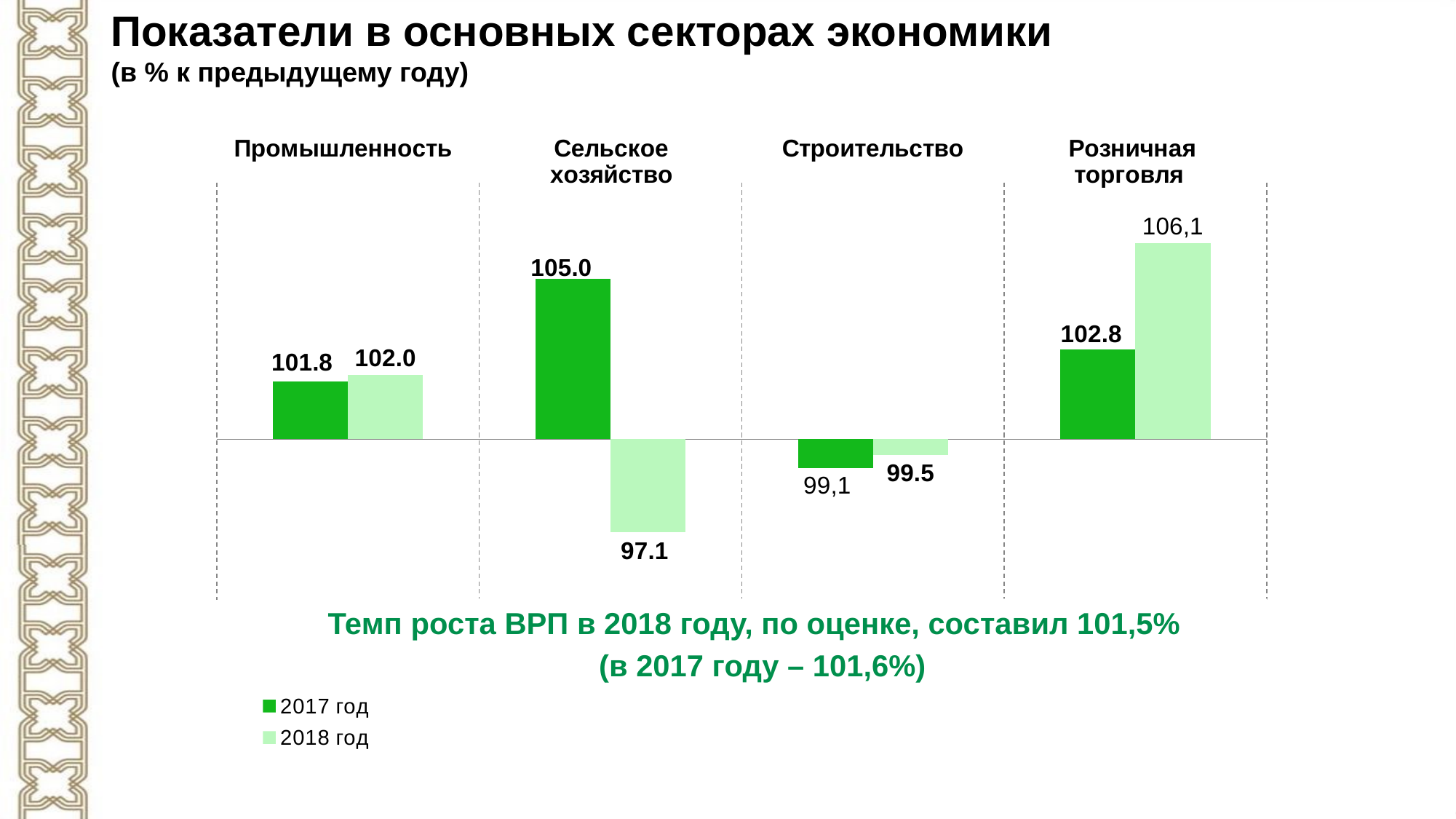
How many categories are shown on the chart? 4 How many series does the legend list? 2 What kind of chart is shown on the slide? Bar chart What is the value for Промышленность in the 2017 год series? 101.8 What is the value for Розничная торговля in the 2018 год series? 106,1 Which category has the highest value in the 2018 год series? Розничная торговля What is the value for Строительство in the 2017 год series? 99,1 Which category has the lowest value in the 2017 год series? Строительство What is the difference between the 2018 год and 2017 год values for Розничная торговля? 3.3 Which is larger for Сельское хозяйство: the 2017 год value or the 2018 год value? 2017 год What is the value for Сельское хозяйство in the 2018 год series? 97.1 What is the difference between the 2017 год and 2018 год values for Сельское хозяйство? 7.9